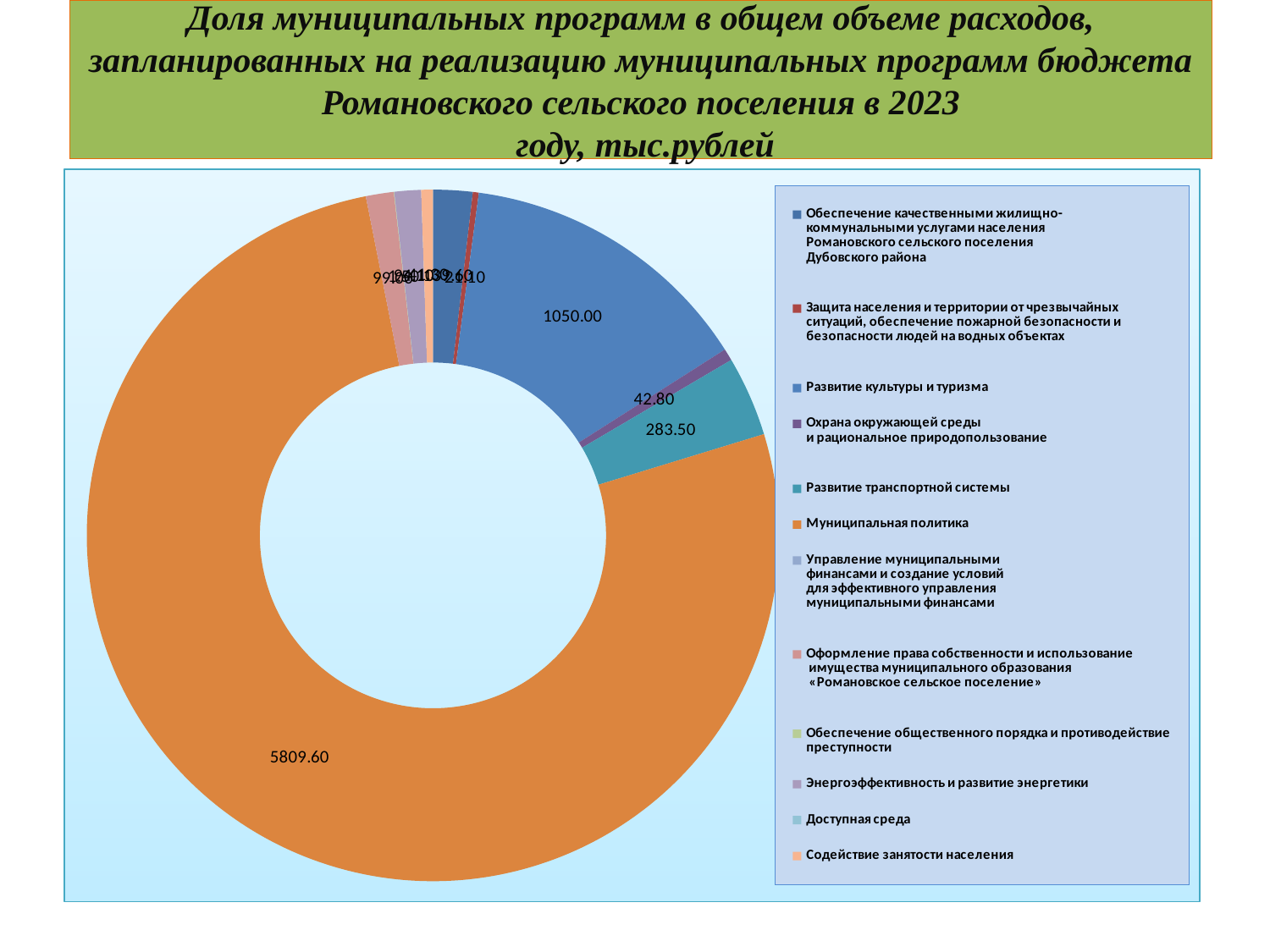
What kind of chart is shown on the slide? Doughnut (pie) chart What is the difference between Развитие культуры и туризма and Развитие транспортной системы? 766.50 What is the value for Охрана окружающей среды и рациональное природопользование? 42.80 Which is larger: Развитие культуры и туризма or Развитие транспортной системы? Развитие культуры и туризма What is the difference between Развитие транспортной системы and Охрана окружающей среды и рациональное природопользование? 240.70 How many categories does the legend list? 12 What is the value for Муниципальная политика? 5809.60 What colour is the slice for Муниципальная политика? Orange Which category has the largest share of the chart? Муниципальная политика What is the value for Развитие культуры и туризма? 1050.00 What is the difference between Муниципальная политика and Развитие культуры и туризма? 4759.60 What is the value for Развитие транспортной системы? 283.50